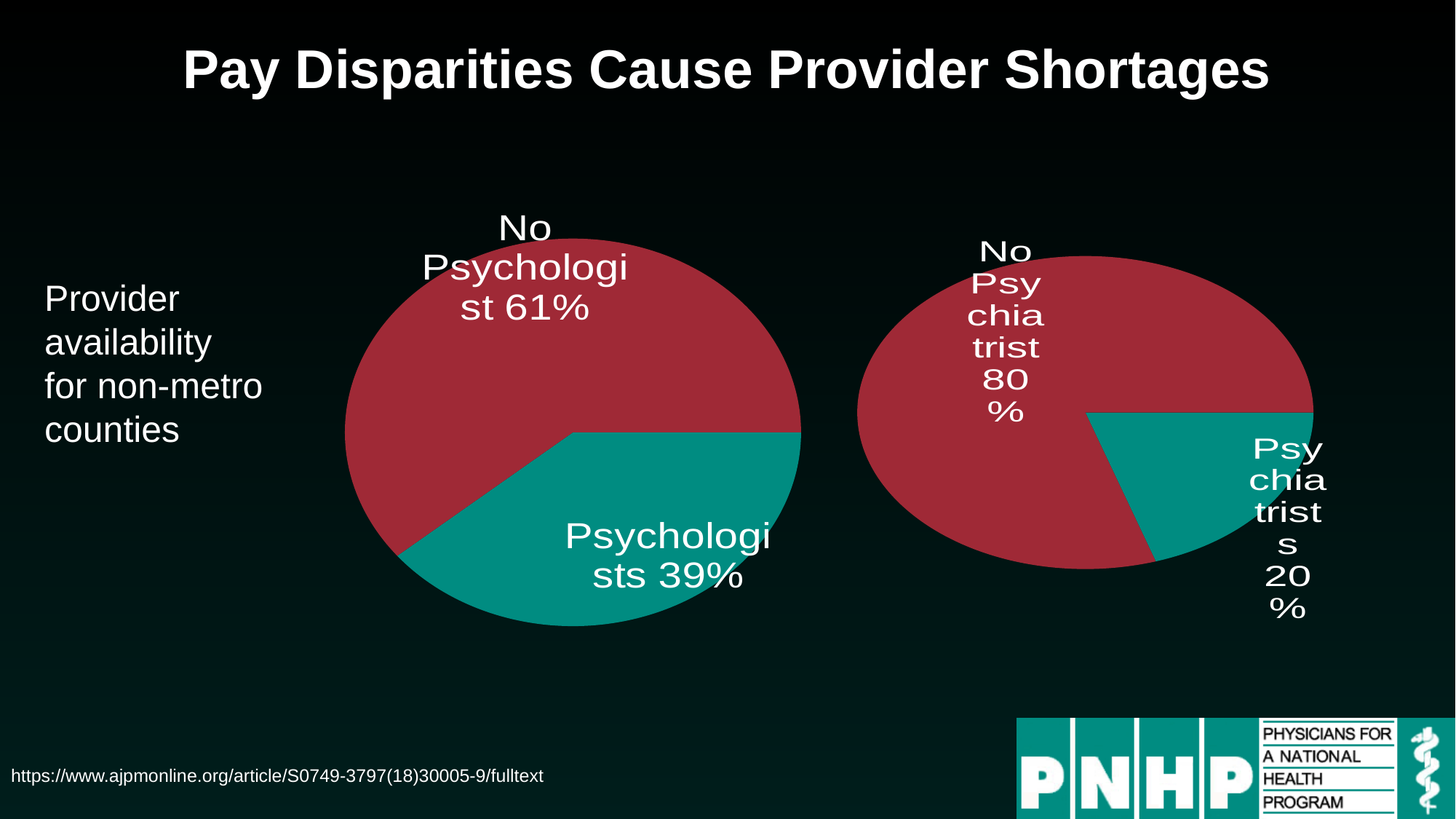
In the left pie chart, what is the difference between the No Psychologist share and the Psychologists share? 22% In the left pie chart, what share of non-metro counties have no psychologist? 61% What colour is the Psychologists slice in the left pie chart? Teal In the right pie chart, what share of non-metro counties have psychiatrists? 20% Which is larger: the share of counties with no psychiatrist in the right chart or the share with no psychologist in the left chart? No Psychiatrist (80%) In the right pie chart, which slice is the smallest? Psychiatrists In the right pie chart, what share of non-metro counties have no psychiatrist? 80% In the left pie chart, what share of non-metro counties have psychologists? 39% How many slices does the right pie chart have? 2 In the right pie chart, what is the difference between the No Psychiatrist share and the Psychiatrists share? 60% What type of chart is used on the left of the slide? Pie chart In the left pie chart, which slice is larger: No Psychologist or Psychologists? No Psychologist